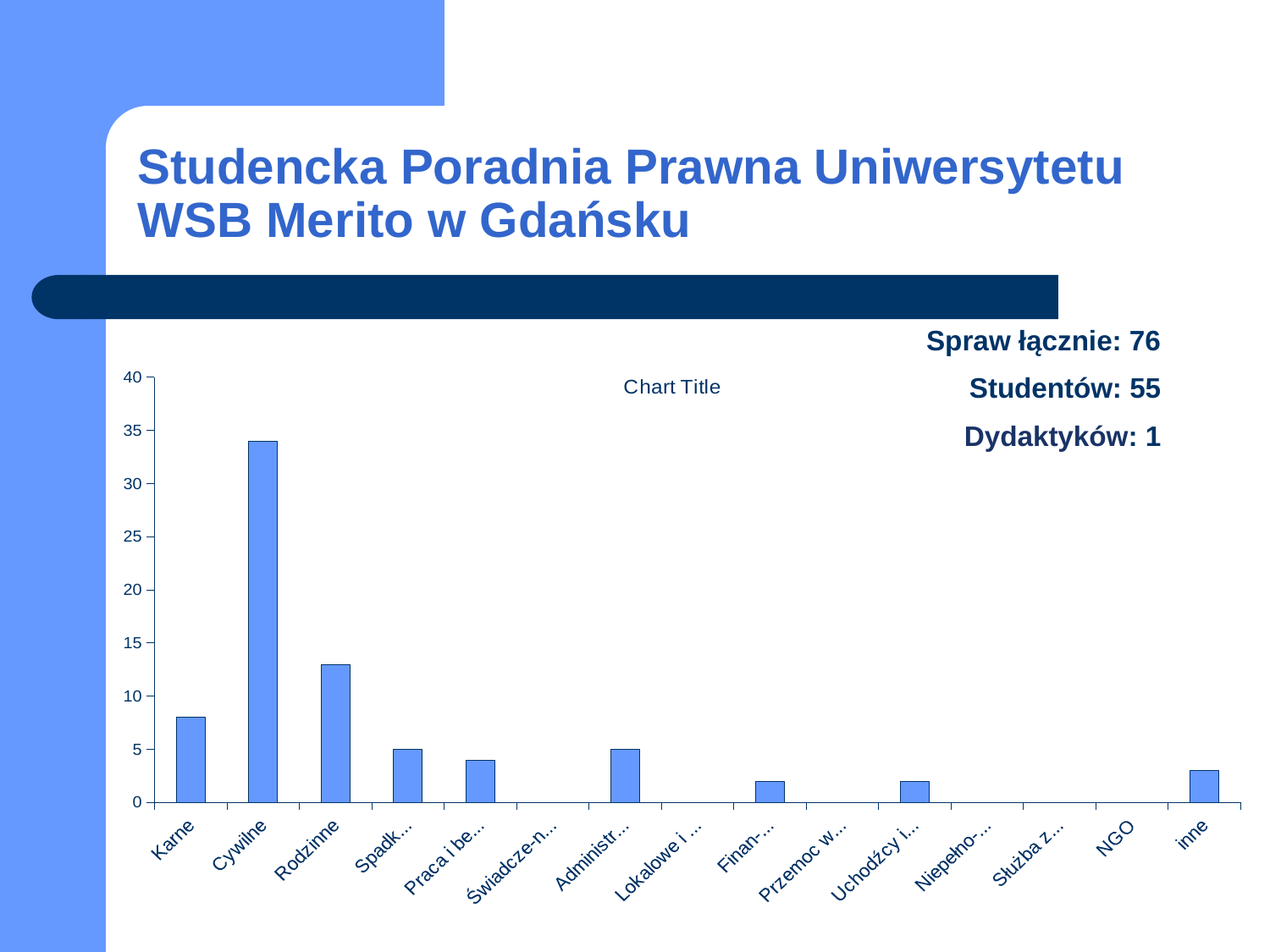
Is the value for Karne greater or less than 10? less What is the title shown on the chart? Chart Title Which is larger, the value for inne or the value for Rodzinne? Rodzinne Is the value for Cywilne greater or less than 30? greater What kind of chart is shown on the slide? bar chart Is the value for Karne greater or less than 5? greater Which is larger, the value for Cywilne or the value for Karne? Cywilne Which category has the highest bar in the chart? Cywilne Which is larger, the value for Karne or the value for Rodzinne? Rodzinne How many categories are shown on the x axis of the chart? 15